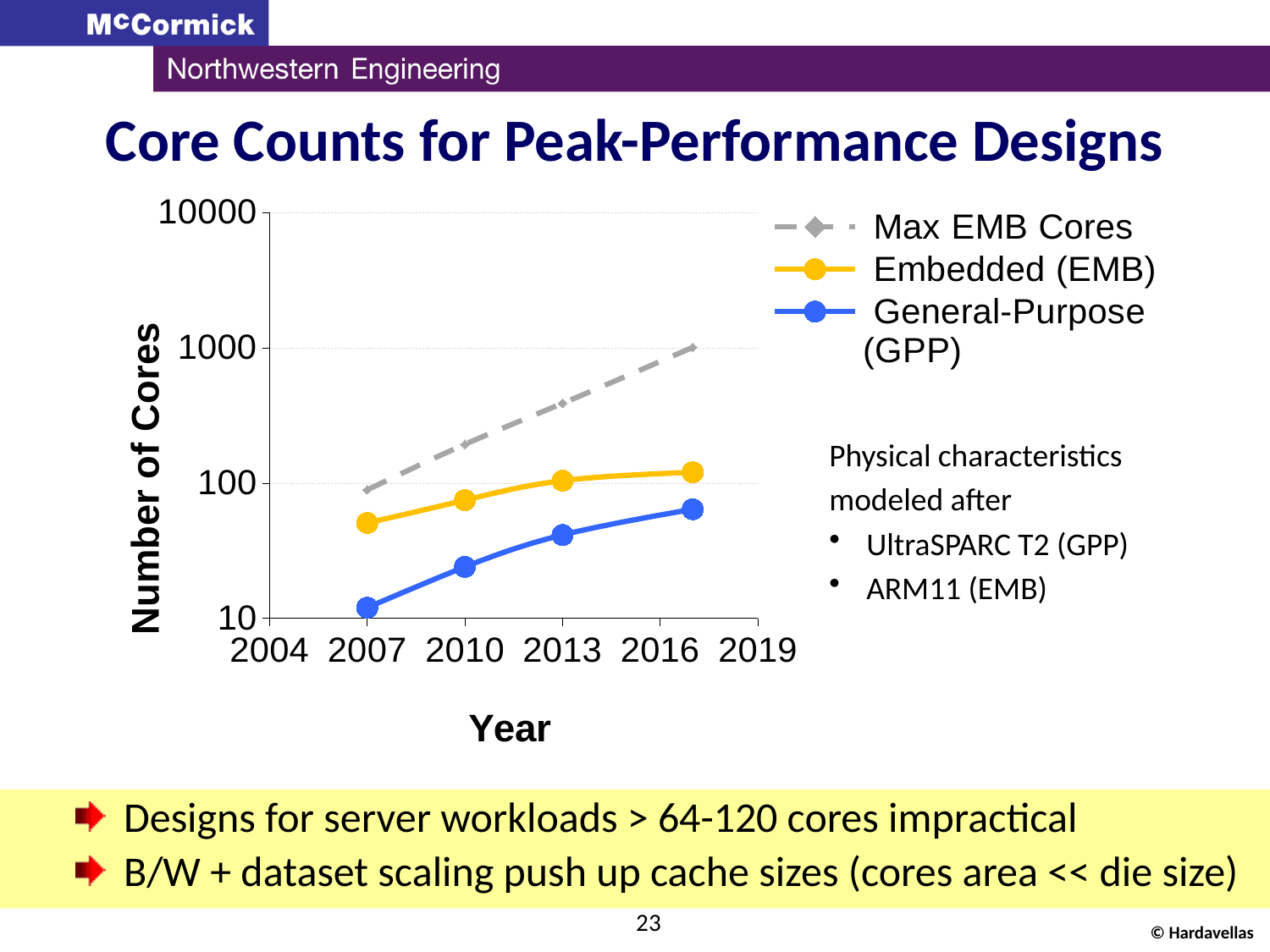
What kind of chart is shown on the slide? line chart Is the value for Max EMB Cores in 2013 greater or less than 1000? less Does the Max EMB Cores series rise or fall as the year increases? rise How many data points are plotted for the General-Purpose (GPP) series? 4 Is the value for General-Purpose (GPP) in 2017 greater or less than 100? less In 2010, which series has the larger value, Embedded (EMB) or General-Purpose (GPP)? Embedded (EMB) What is the title of the chart? Core Counts for Peak-Performance Designs What is the label of the y axis? Number of Cores Does the General-Purpose (GPP) series rise or fall as the year increases? rise How many series does the chart legend list? 3 Is the value for Embedded (EMB) in 2017 greater or less than 100? greater Which series has the highest value in 2013? Max EMB Cores